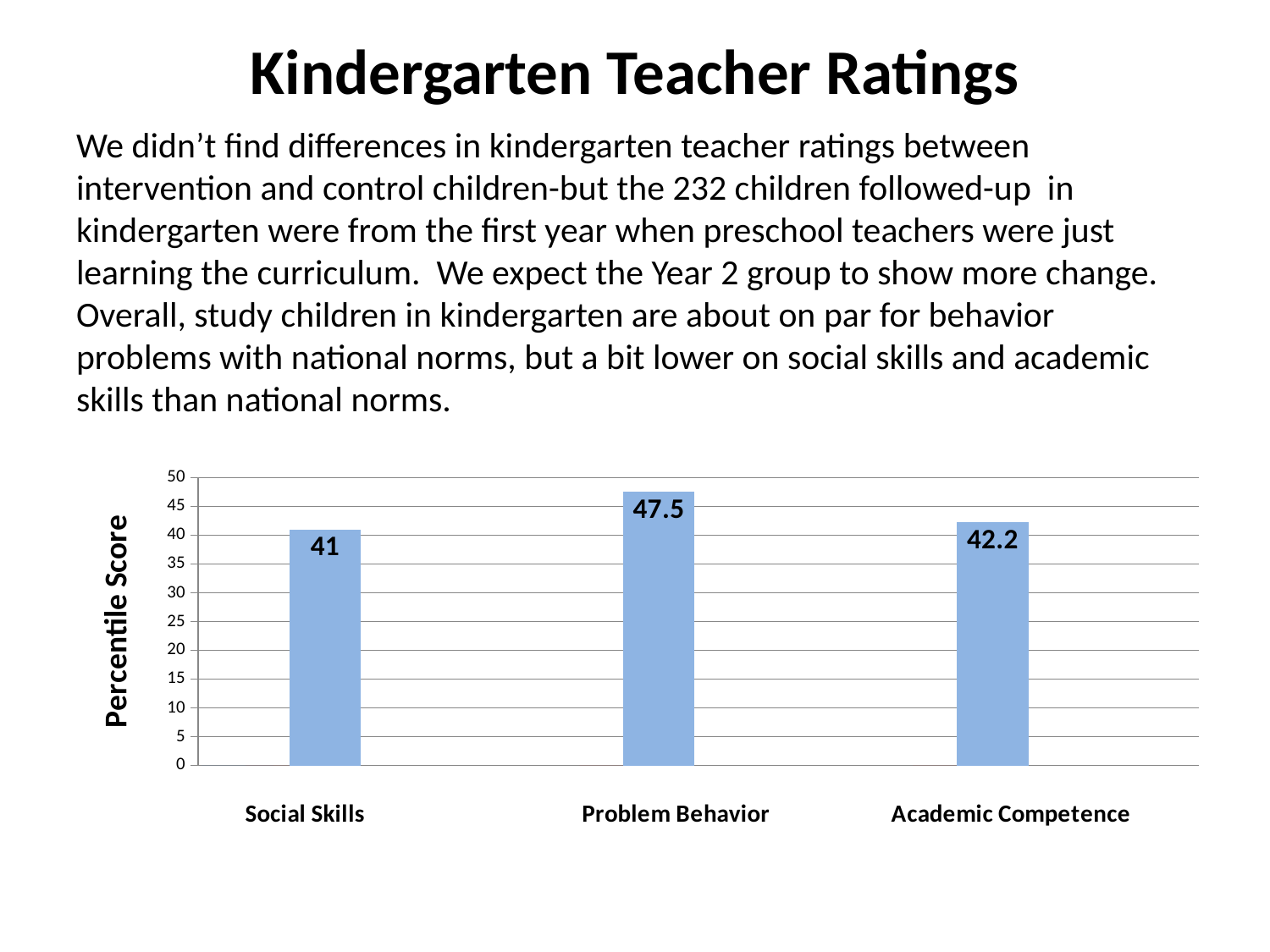
What is the percentile score for Social Skills? 41 Which category has the highest percentile score? Problem Behavior Which is larger, the percentile score for Problem Behavior or for Academic Competence? Problem Behavior What kind of chart is shown on the slide? bar chart Which category has the lowest percentile score? Social Skills How many categories are shown in the chart? 3 Is the value for Problem Behavior greater or less than 45? greater What is the percentile score for Academic Competence? 42.2 What is the percentile score for Problem Behavior? 47.5 What is the label on the vertical axis of the chart? Percentile Score What is the difference between the Problem Behavior and Social Skills percentile scores? 6.5 What is the difference between the Academic Competence and Social Skills percentile scores? 1.2